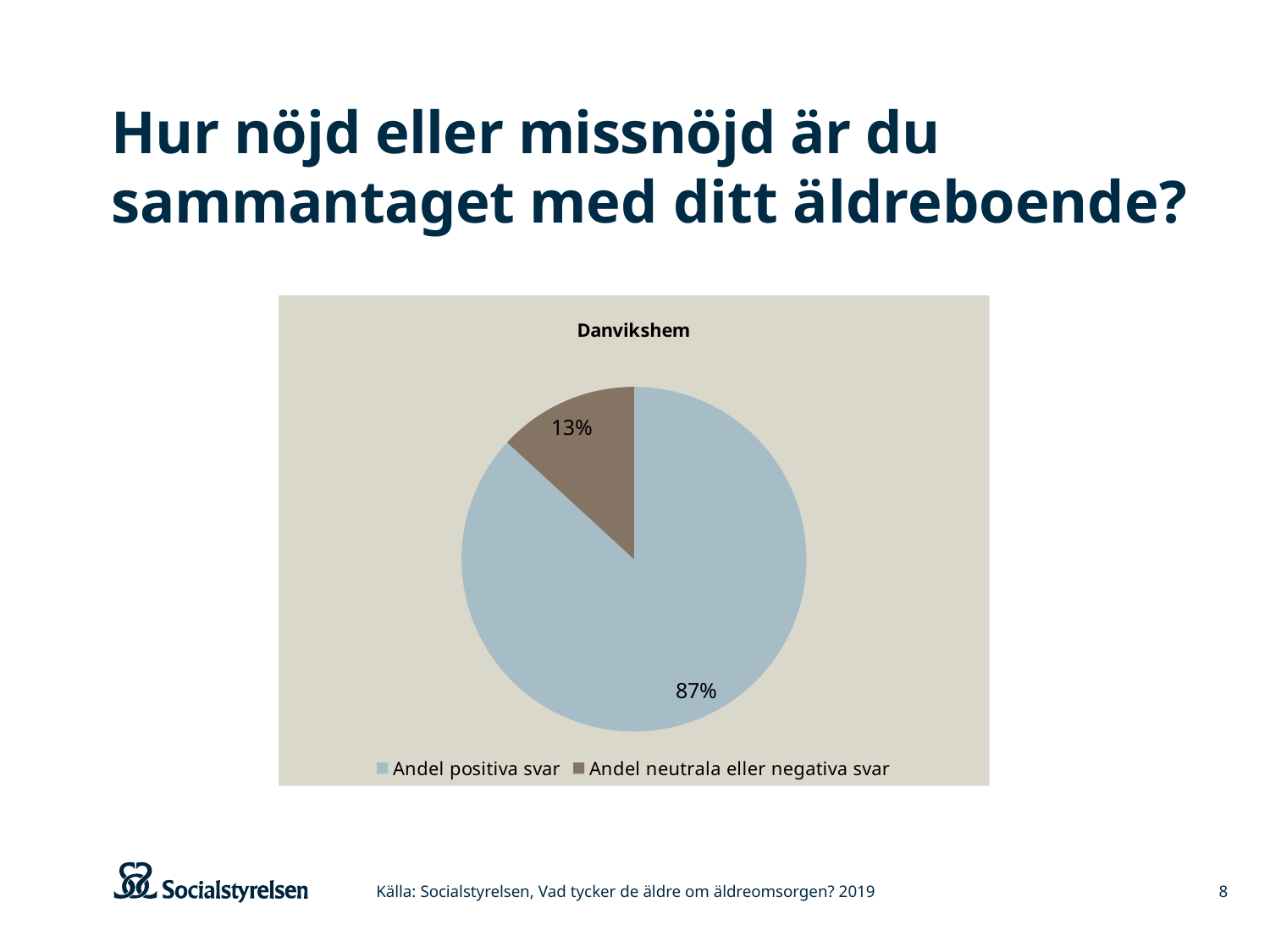
Which slice of the pie is the smallest? Andel neutrala eller negativa svar What is the total of the two slices shown in the pie chart? 100% Which slice of the pie is the largest? Andel positiva svar What kind of chart is shown on the slide? pie chart What share of responses is 'Andel neutrala eller negativa svar'? 13% What share of responses is 'Andel positiva svar'? 87% How many slices does the pie chart have? 2 How many entries does the legend list? 2 What is the chart's title? Danvikshem What is the difference in percentage points between 'Andel positiva svar' and 'Andel neutrala eller negativa svar'? 74 percentage points What colour is the slice for 'Andel neutrala eller negativa svar'? brown Which is larger, 'Andel positiva svar' or 'Andel neutrala eller negativa svar'? Andel positiva svar